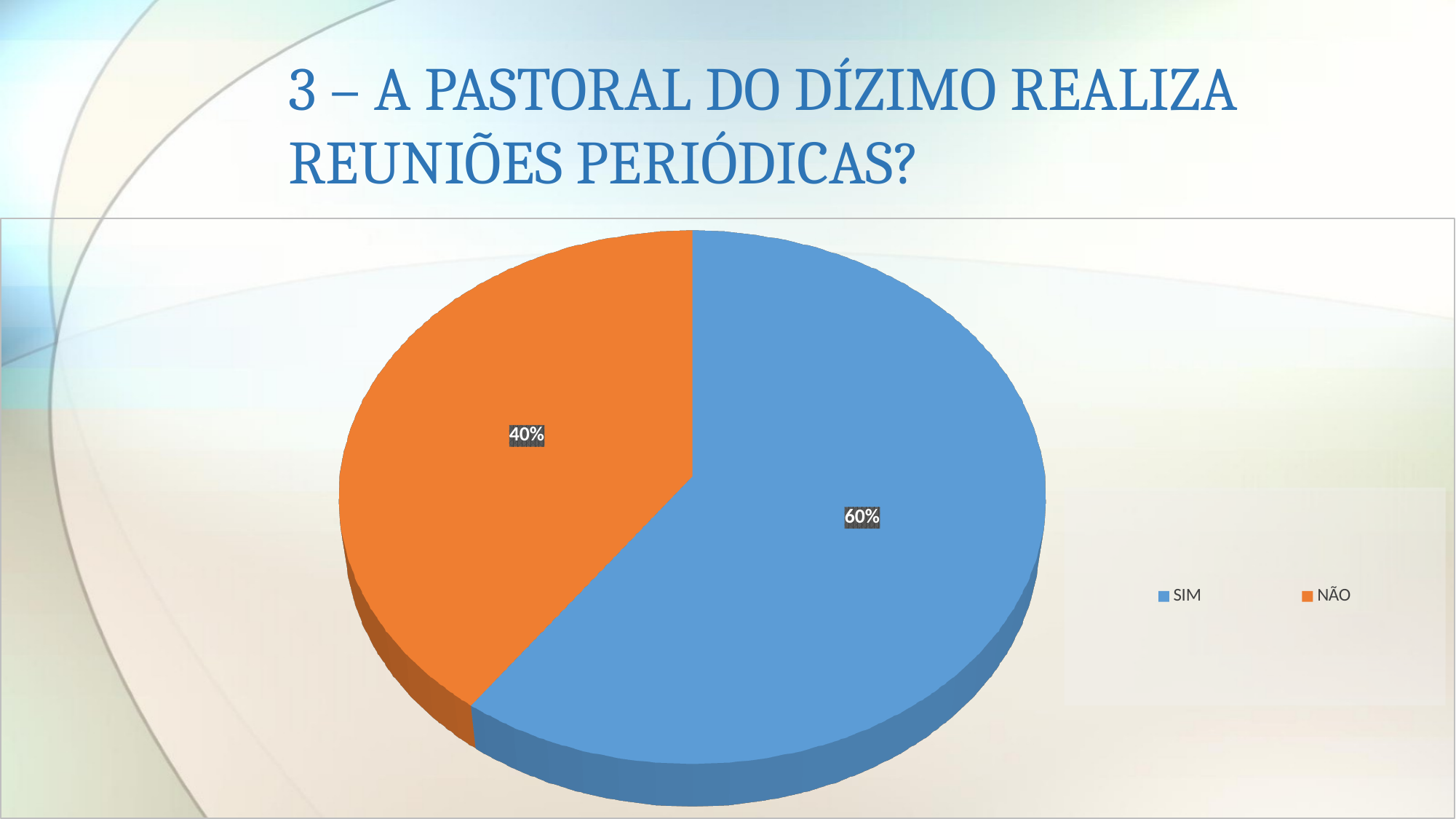
Which category has the smallest share of the pie? NÃO How many slices does the pie chart have? 2 What percentage of the pie is labelled NÃO? 40% What colour is the SIM slice? blue How many entries does the legend list? 2 Which is larger, the share for SIM or the share for NÃO? SIM What colour is the NÃO slice? orange What kind of chart is shown on the slide? pie chart What percentage of the pie is labelled SIM? 60% What is the difference in percentage points between the SIM and NÃO slices? 20% Which category has the largest share of the pie? SIM